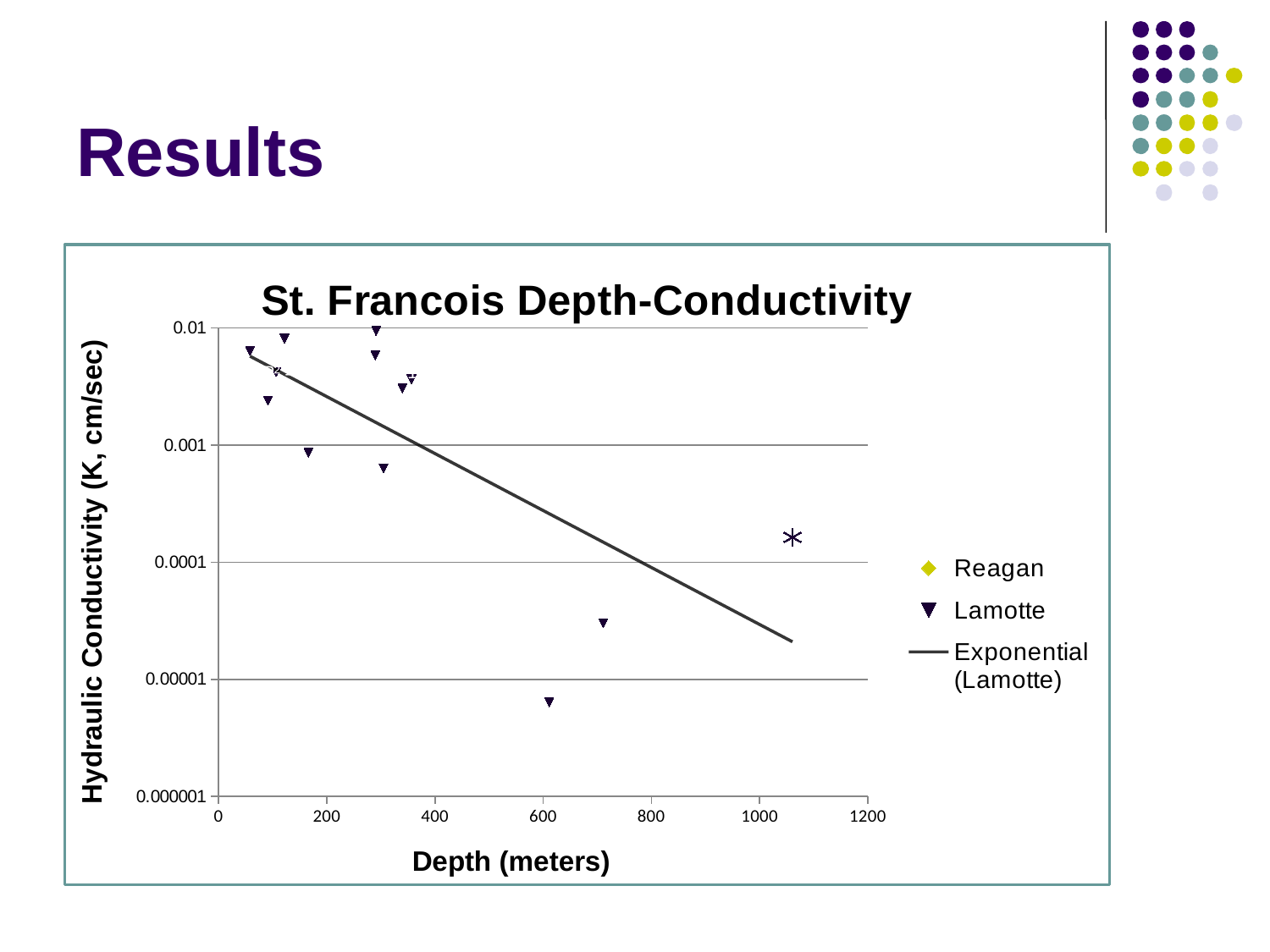
What is the title of the chart? St. Francois Depth-Conductivity What kind of chart is shown on the slide? Scatter chart How many entries does the chart's legend list? 3 Does the Exponential (Lamotte) trend line rise or fall as depth increases? Fall Is the value of the Exponential (Lamotte) trend line at 1000 m depth greater or less than 0.0001? less Is the value of the Exponential (Lamotte) trend line at 200 m depth greater or less than 0.001? greater Is the hydraulic conductivity of the lowest Lamotte point (near 600 m depth) greater or less than 0.00001? less What is the label of the x axis of the chart? Depth (meters)